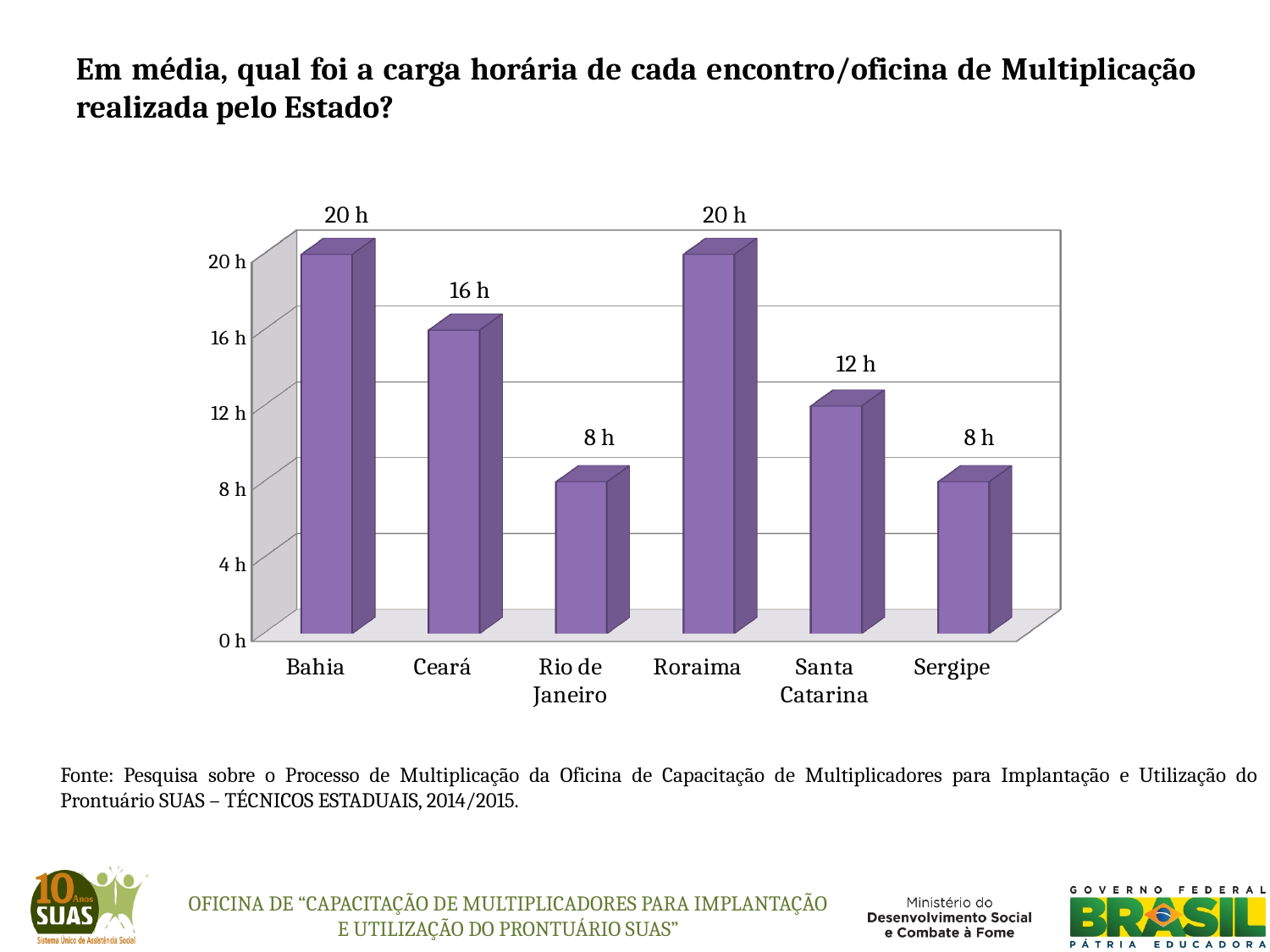
What is the value for Santa Catarina? 12 h What colour are the bars in the chart? purple What is the value for Ceará? 16 h How many categories are shown on the x axis? 6 What is the difference between the values for Santa Catarina and Rio de Janeiro? 4 h Which is larger, the value for Ceará or the value for Santa Catarina? Ceará What is the value for Bahia? 20 h What is the value for Sergipe? 8 h What kind of chart is shown on the slide? bar chart Is the value for Santa Catarina greater or less than 8 h? greater What is the difference between the values for Bahia and Ceará? 4 h Which category has the lowest value? Rio de Janeiro and Sergipe